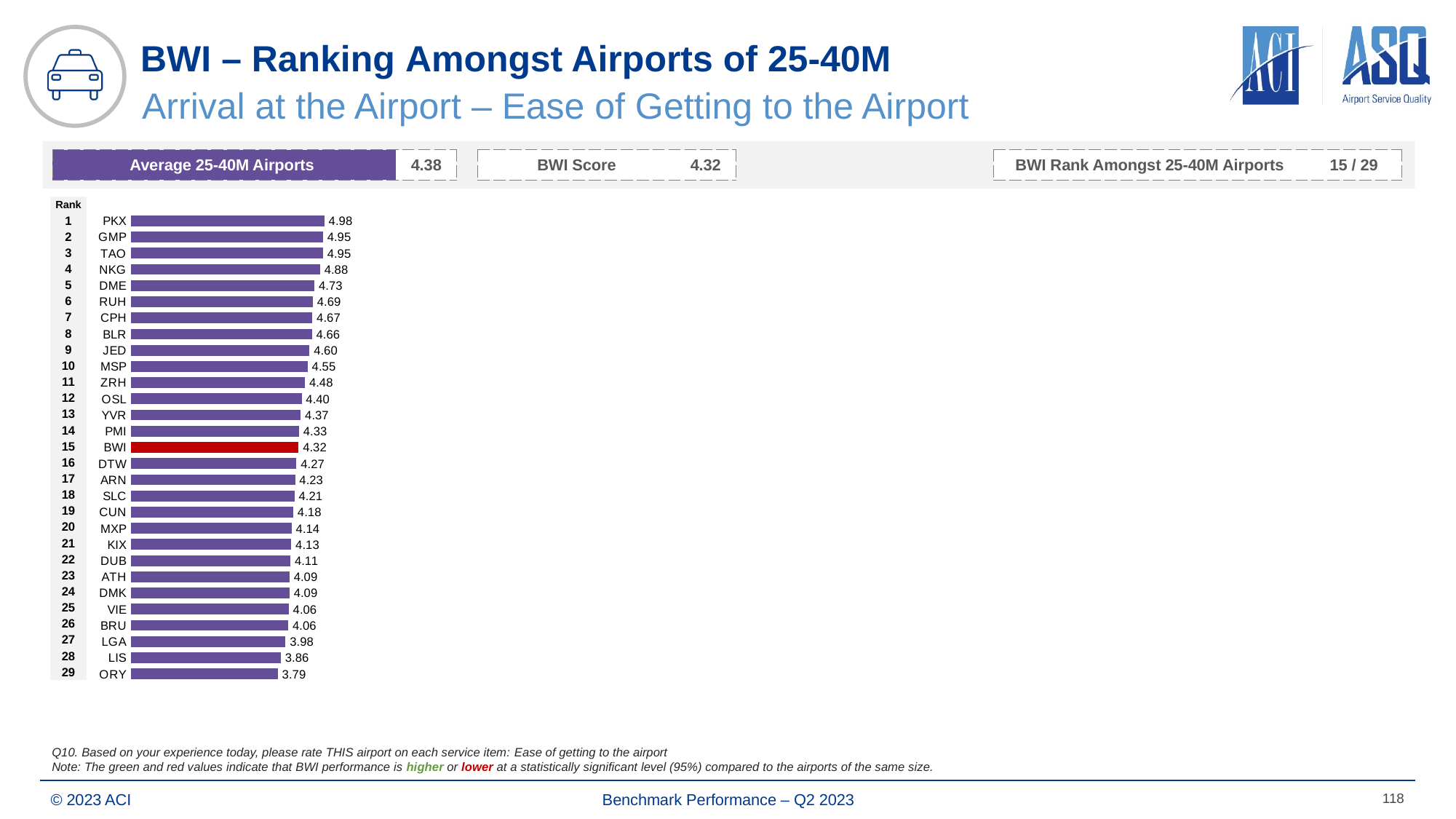
What kind of chart is shown on the slide? Bar chart What is the value for BWI in the chart? 4.32 Which has a larger value, DME or MSP? DME What is the value for ORY in the chart? 3.79 How many airports are shown in the chart? 29 Which airport has the lowest value in the chart? ORY What is the value for PKX in the chart? 4.98 Which has a larger value, LIS or ZRH? ZRH What is the difference between the values for BWI and ORY? 0.53 What is the difference between the values for PKX and BWI? 0.66 Which airport's bar is highlighted in red in the chart? BWI Which airport has the highest value in the chart? PKX